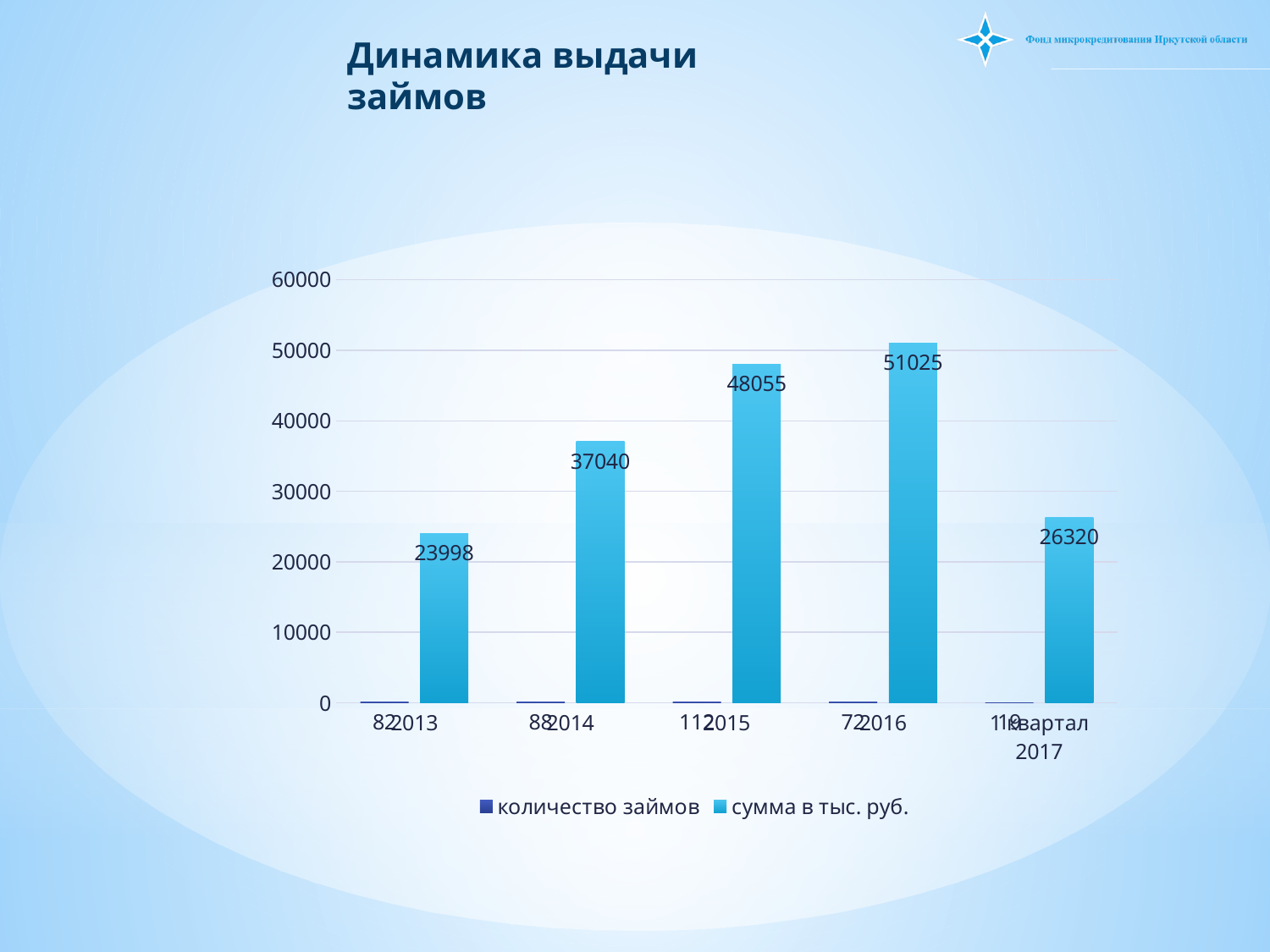
What kind of chart is shown on the slide? bar chart What is the difference between the "сумма в тыс. руб." values for 2016 and 2015? 2970 What is the value of "сумма в тыс. руб." for 2016? 51025 Which category has the highest value for "сумма в тыс. руб."? 2016 Which has a larger "сумма в тыс. руб." value: 2014 or I квартал 2017? 2014 How many series does the legend list? 2 How many categories are shown on the x axis? 5 Which category has the lowest value for "сумма в тыс. руб."? 2013 What is the value of "сумма в тыс. руб." for 2013? 23998 Is the "сумма в тыс. руб." value for 2015 greater or less than 40000? greater What is the value of "сумма в тыс. руб." for I квартал 2017? 26320 What is the title of the chart? Динамика выдачи займов